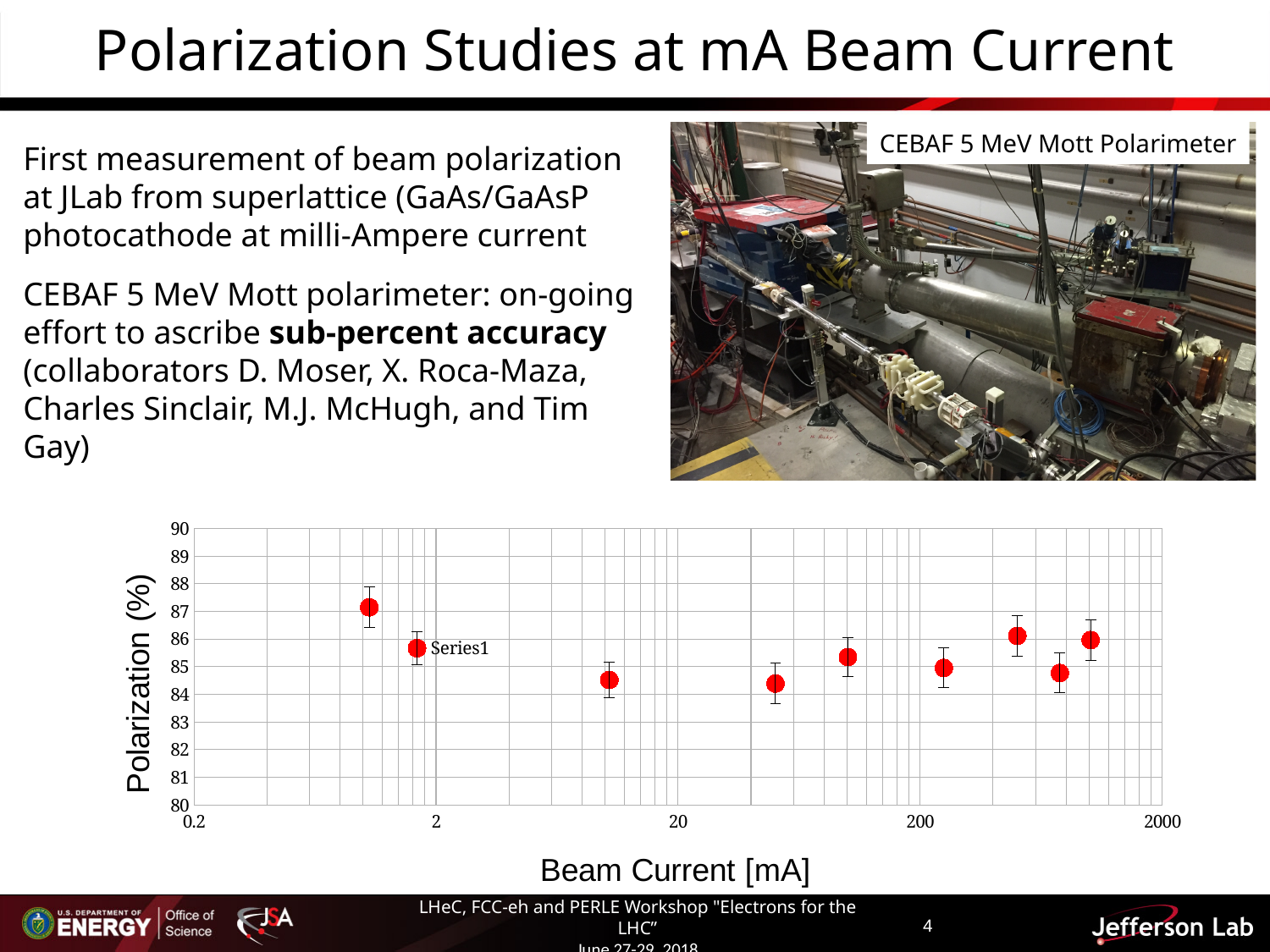
What kind of chart is shown on the slide? Scatter chart What is the title of the x axis of the chart? Beam Current [mA] Which has the larger polarization value: the data point near 50 mA or the data point near 500 mA? The data point near 500 mA Which data point has the highest polarization value: the leftmost point (near 1 mA) or any other point? The leftmost point (near 1 mA) What is the maximum value shown on the y axis of the chart? 90 Is the polarization value of the data point near 10 mA greater or less than 85? less How many data points are plotted in the chart? 9 Which has the larger polarization value: the leftmost data point or the data point near 10 mA? The leftmost data point Do the polarization values rise or fall from the first data point to the second data point along the x axis? fall Is the polarization value of the leftmost data point greater or less than 86? greater What is the title of the y axis of the chart? Polarization (%) Is the polarization value of the rightmost data point (near 1200 mA) greater or less than 85? greater